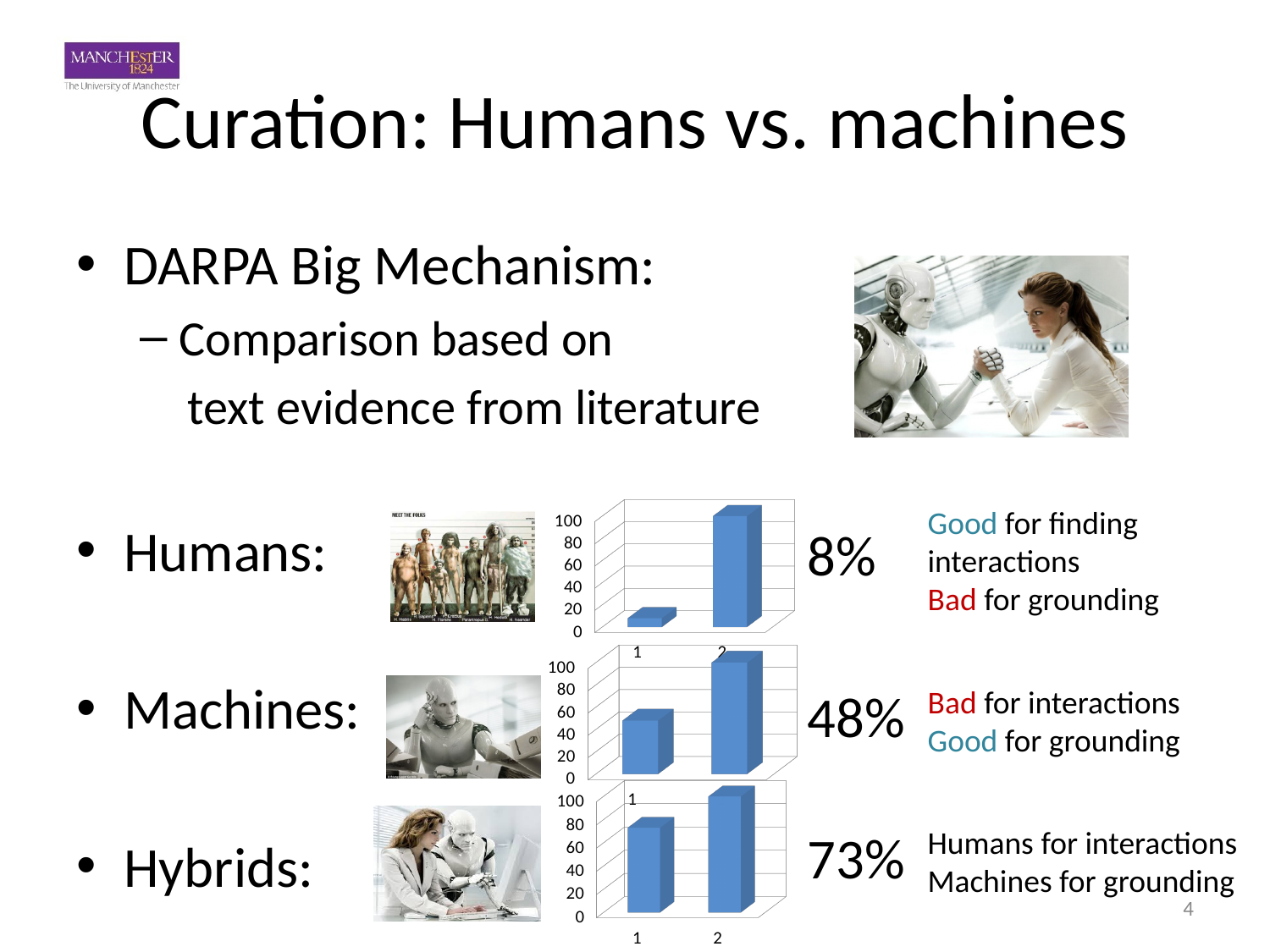
In the chart next to 'Hybrids:', is the value for category 1 greater or less than 60? greater What kind of chart is shown next to 'Humans:'? bar chart What is the highest tick value shown on the y axis of the chart next to 'Machines:'? 100 In the chart next to 'Humans:', is the value for category 1 greater or less than 20? less In the chart next to 'Machines:', do the values rise or fall from category 1 to category 2? rise In the chart next to 'Humans:', is the value for category 2 greater or less than 80? greater How many categories are plotted in the chart next to 'Humans:'? 2 In the chart next to 'Hybrids:', which category has the larger value, 1 or 2? 2 In the chart next to 'Machines:', which category has the lowest value? 1 In the chart next to 'Humans:', which category has the highest value? 2